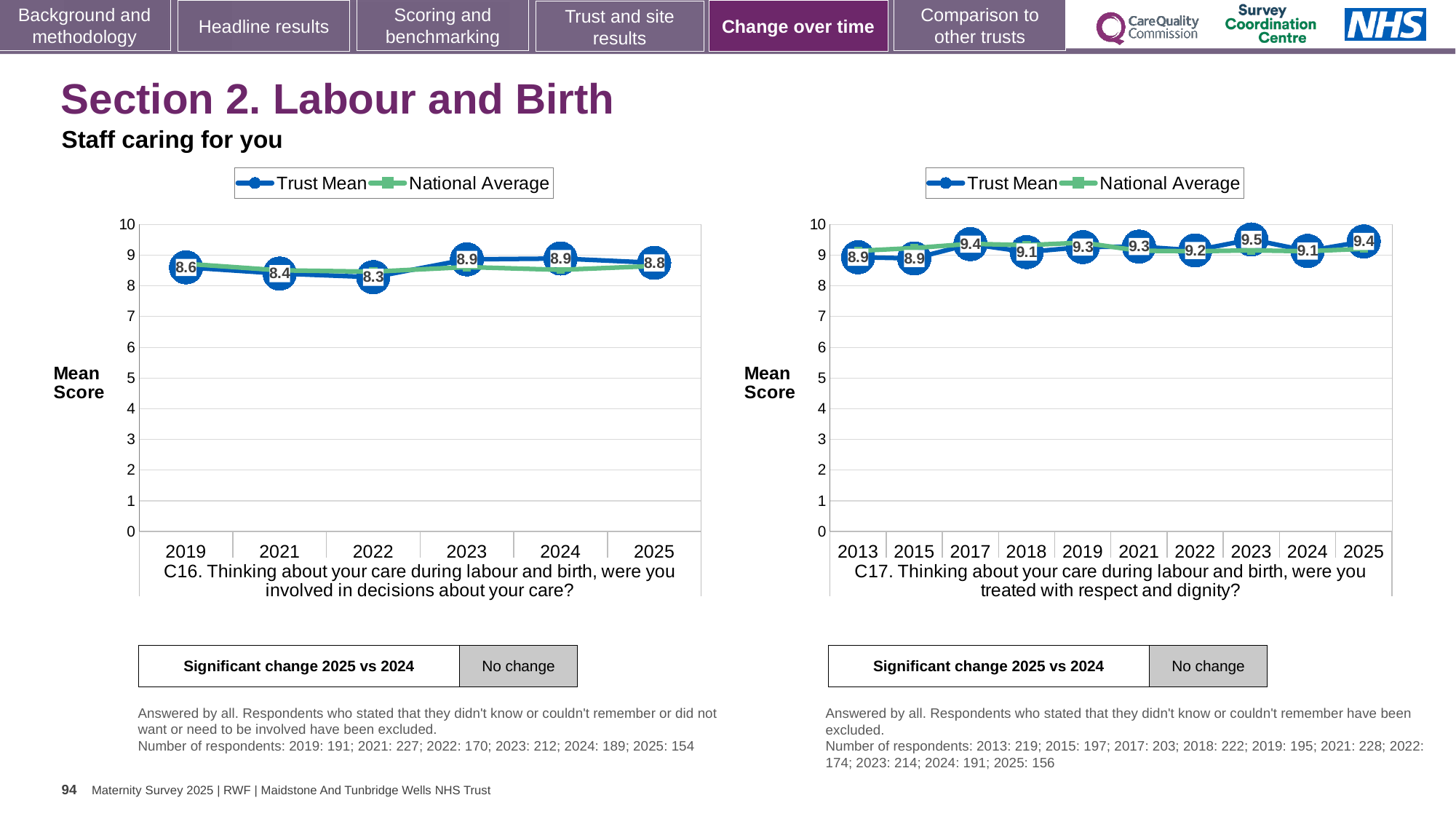
In the C16 chart (left), what is the Trust Mean for 2025? 8.8 In the C16 chart (left), how many years are shown on the x axis? 6 In the C17 chart (right), is the Trust Mean higher in 2025 or in 2024? 2025 In the C16 chart (left), what is the Trust Mean for 2022? 8.3 In the C17 chart (right), what is the Trust Mean for 2017? 9.4 In the C16 chart (left), what is the difference between the Trust Mean in 2023 and in 2022? 0.6 In the C16 chart (left), how many series does the legend list? 2 In the C17 chart (right), what is the difference between the Trust Mean in 2023 and in 2013? 0.6 In the C17 chart (right), which year has the highest Trust Mean? 2023 What type of chart is the C17 chart (right)? Line chart In the C16 chart (left), which year has the lowest Trust Mean? 2022 In the C17 chart (right), how many years are shown on the x axis? 10